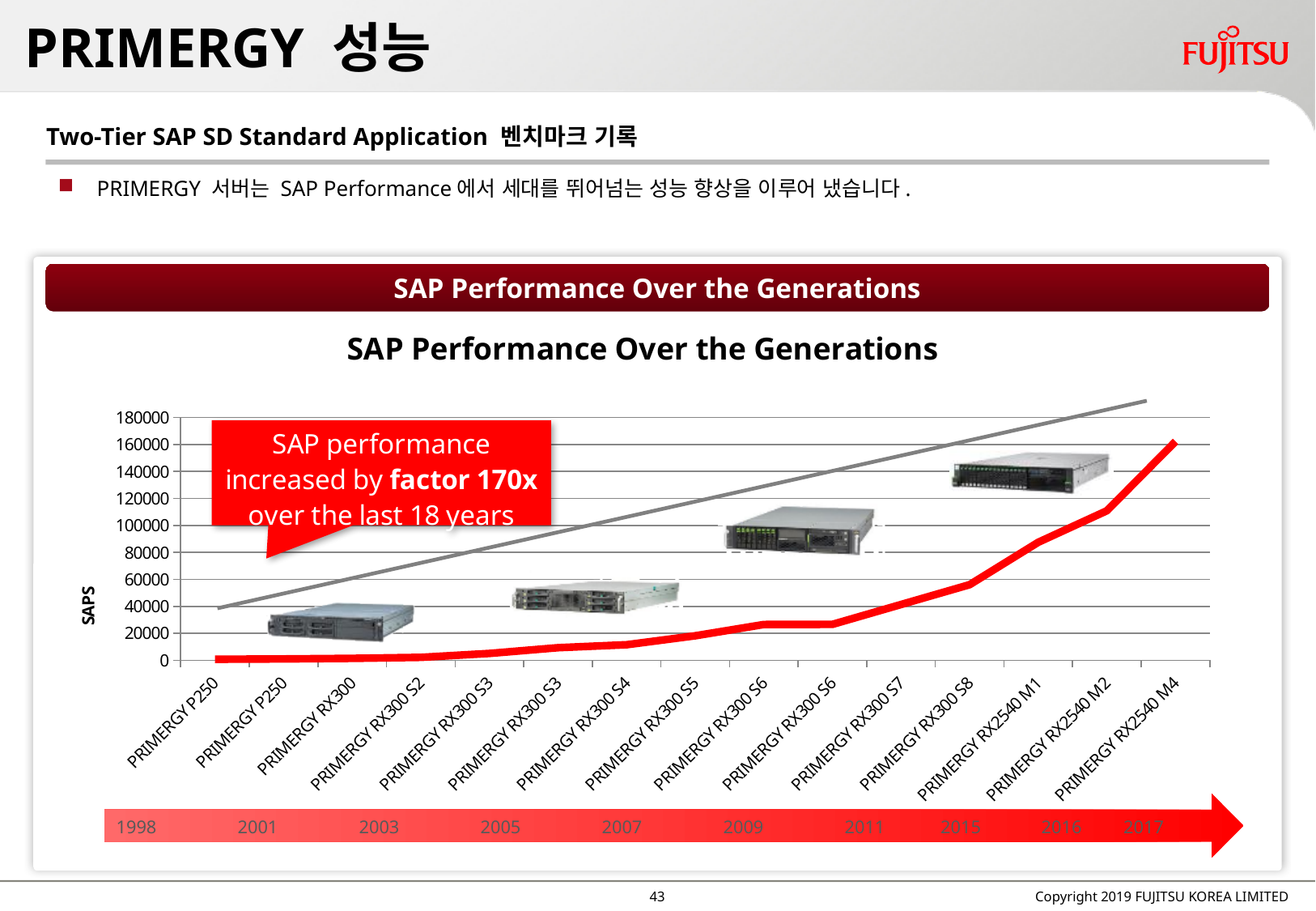
Which category has the highest SAPS value in the chart? PRIMERGY RX2540 M4 Is the value for PRIMERGY RX300 S8 greater or less than 80000? less Which has the larger value, PRIMERGY RX2540 M4 or PRIMERGY RX2540 M2? PRIMERGY RX2540 M4 Is the value for PRIMERGY RX2540 M4 greater or less than 140000? greater By what factor does the annotation on the chart say SAP performance increased over the last 18 years? 170x Do the SAPS values generally rise or fall from left to right along the x axis? rise What kind of chart is shown under the title "SAP Performance Over the Generations"? line chart Which has the larger value, PRIMERGY RX2540 M1 or PRIMERGY RX300 S7? PRIMERGY RX2540 M1 Is the value for PRIMERGY RX300 S7 greater or less than 60000? less How many server categories are listed along the x axis of the chart? 15 What is the label on the y axis of the chart? SAPS